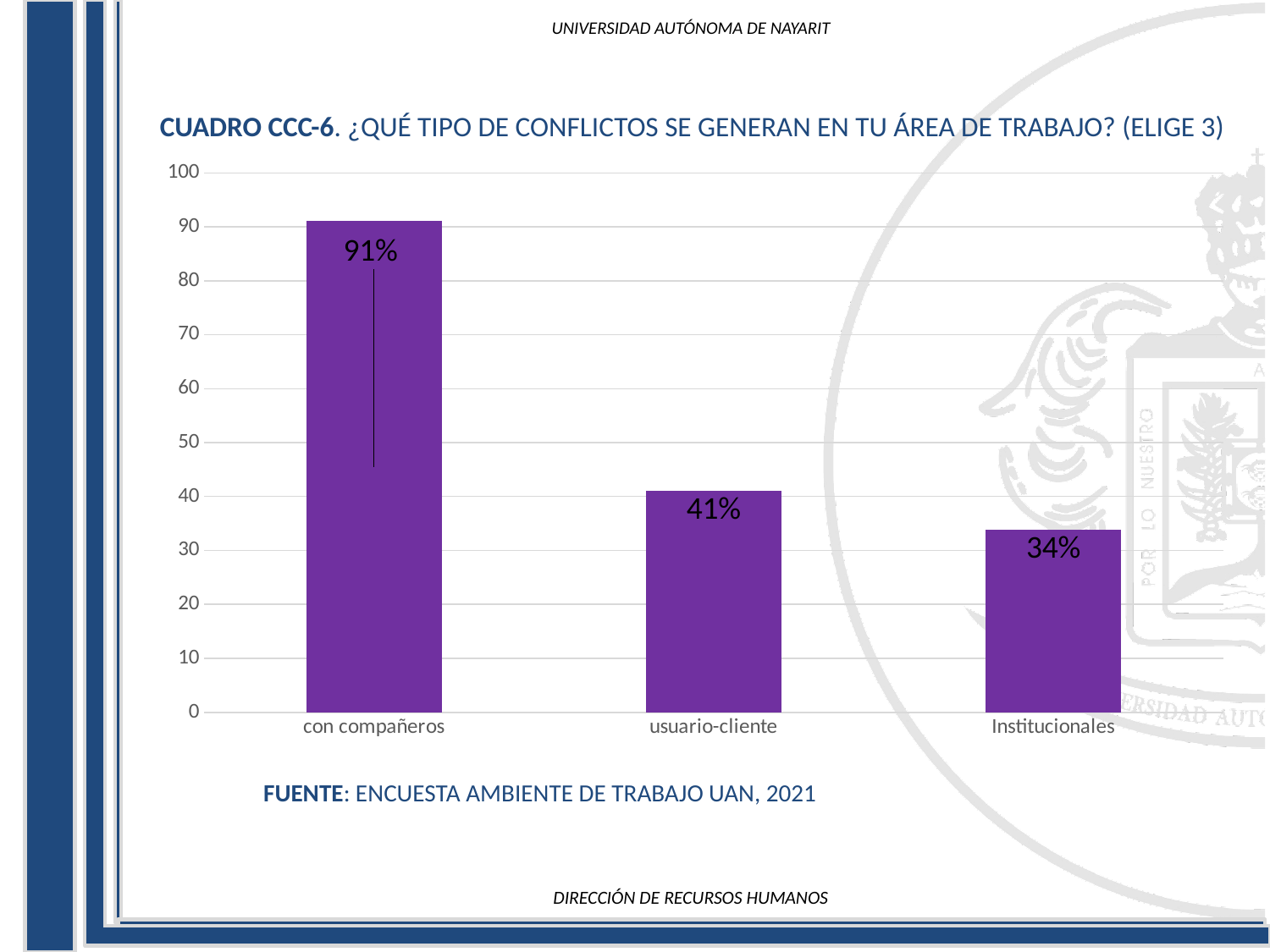
Is the value for "Institucionales" greater or less than 40? less How many categories are shown on the chart? 3 What is the difference between the values for "con compañeros" and "usuario-cliente"? 50% Which is larger, the value for "usuario-cliente" or the value for "Institucionales"? usuario-cliente What is the value for "usuario-cliente"? 41% What is the value for "Institucionales"? 34% What is the difference between the values for "usuario-cliente" and "Institucionales"? 7% Which category has the lowest value? Institucionales Which category has the highest value? con compañeros What kind of chart is shown on the slide? bar chart What source is cited below the chart? ENCUESTA AMBIENTE DE TRABAJO UAN, 2021 What is the value for "con compañeros"? 91%